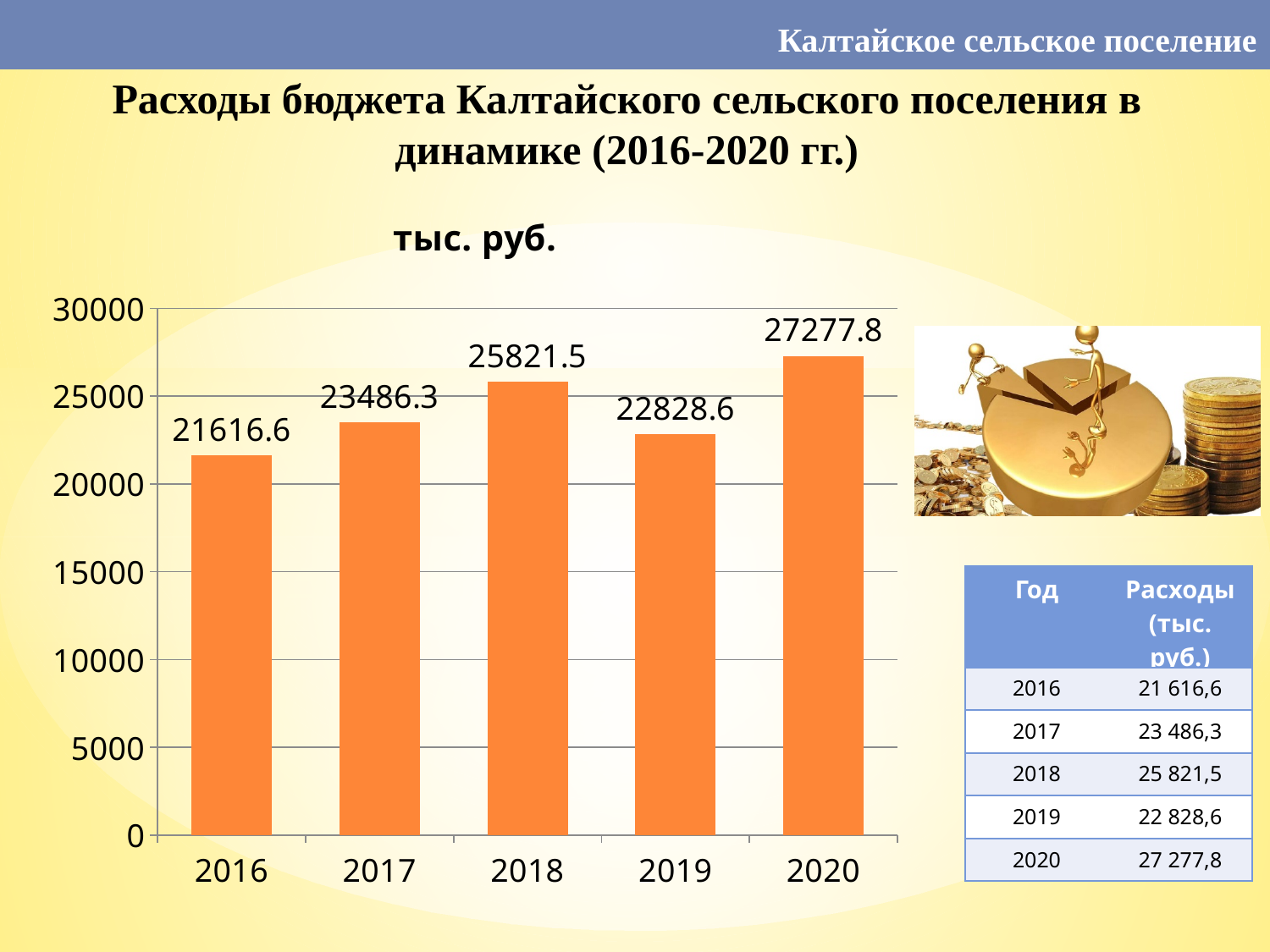
What kind of chart is shown? bar chart Which year has the highest value? 2020 What is the value for 2016? 21616.6 Is the value for 2018 greater or less than 25000? greater What is the value for 2018? 25821.5 Which is larger, the value for 2017 or the value for 2019? 2017 What is the value for 2020? 27277.8 How many years are shown on the x axis? 5 Which year has the lowest value? 2016 Does the value rise or fall from 2018 to 2019? fall What is the difference between the values for 2018 and 2019? 2992.9 What is the difference between the values for 2020 and 2016? 5661.2